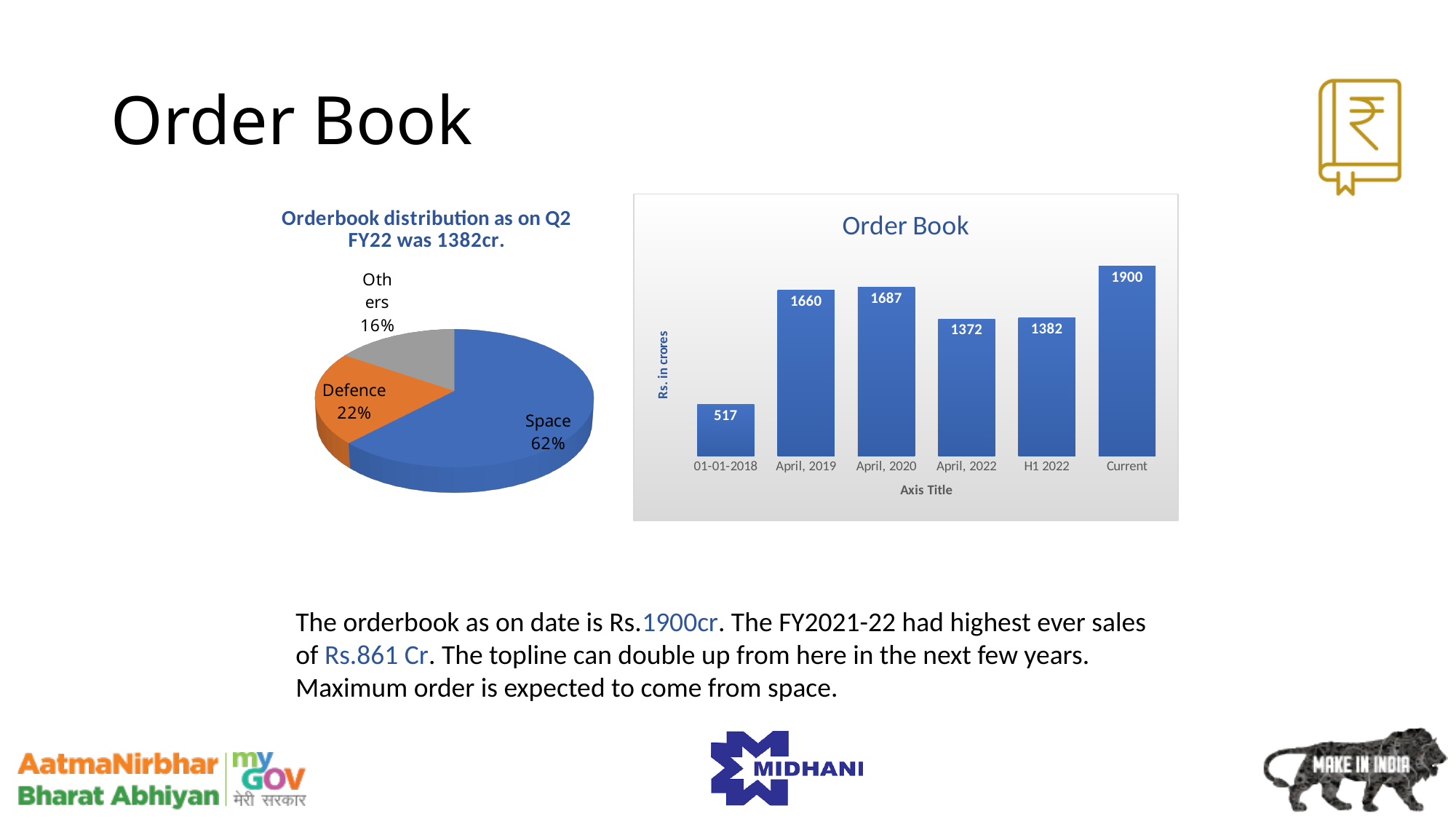
In the pie chart 'Orderbook distribution as on Q2 FY22 was 1382cr.', what share does Space have? 62% In the 'Order Book' bar chart, which category has the lowest value? 01-01-2018 In the 'Order Book' bar chart, what is the difference between the Current value and the April, 2022 value? 528 In the 'Order Book' bar chart, what is the value for H1 2022? 1382 How many bars are shown in the 'Order Book' bar chart? 6 In the 'Order Book' bar chart, which is larger: the value for April, 2020 or the value for April, 2019? April, 2020 What is the y-axis label of the 'Order Book' bar chart? Rs. in crores In the pie chart 'Orderbook distribution as on Q2 FY22 was 1382cr.', which slice is the smallest? Others In the 'Order Book' bar chart, which category has the highest value? Current In the 'Order Book' bar chart, what is the value for April, 2019? 1660 What type of chart is the 'Order Book' chart on the right? Bar chart In the pie chart 'Orderbook distribution as on Q2 FY22 was 1382cr.', what is the difference between the Defence share and the Others share? 6%